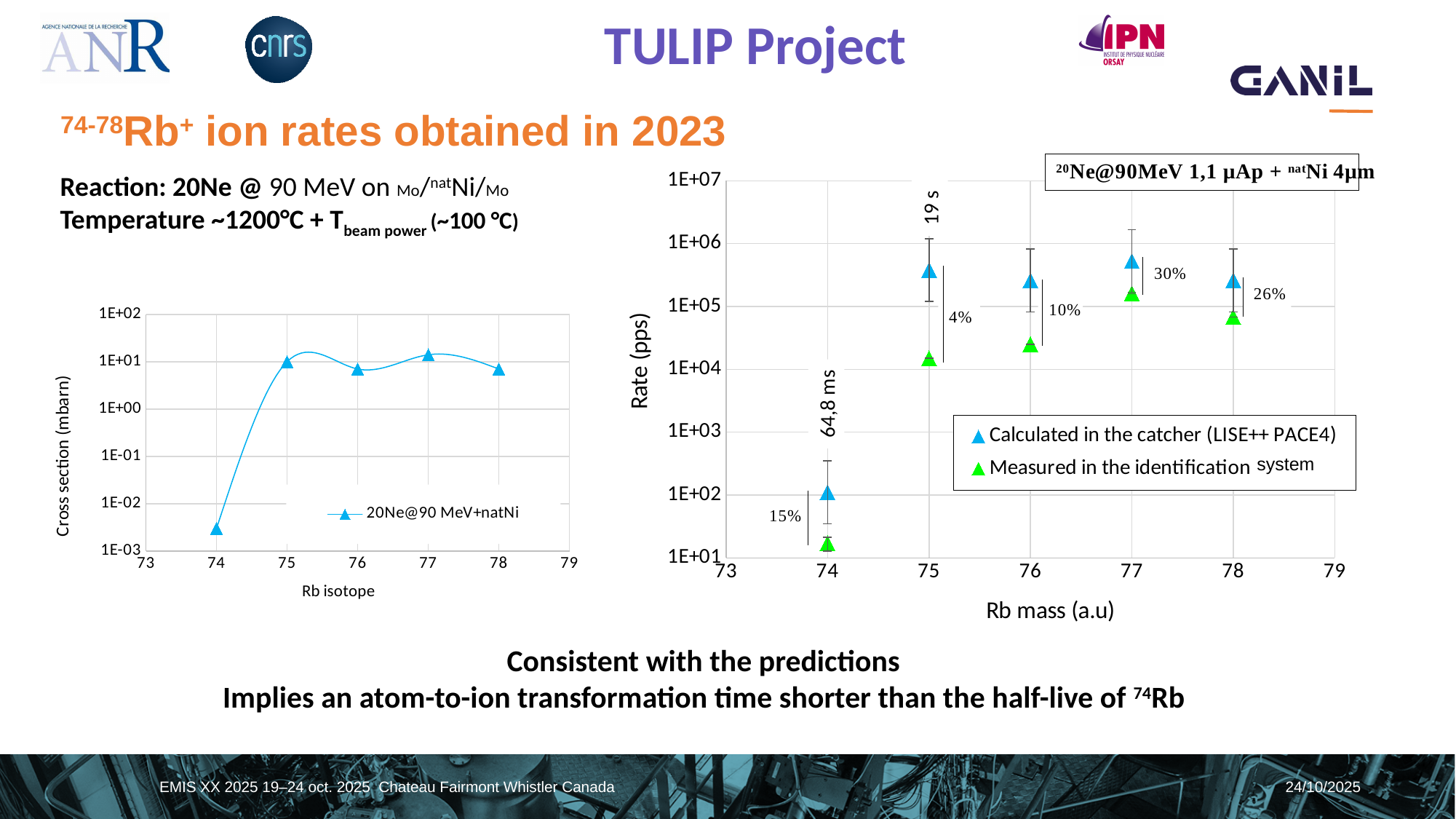
In the right chart (Rate vs Rb mass), how many series does the legend list? 2 In the right chart (Rate vs Rb mass), which Rb mass has the highest measured rate (green series)? 77 In the right chart (Rate vs Rb mass), is the measured rate at Rb mass 77 greater or less than 1E+05? greater In the left chart (Cross section vs Rb isotope), is the cross section for isotope 75 greater or less than 1E+00? greater In the right chart (Rate vs Rb mass), at Rb mass 74, which is larger: the calculated rate or the measured rate? calculated rate In the right chart (Rate vs Rb mass), what percentage label is printed next to the points at Rb mass 77? 30% In the left chart (Cross section vs Rb isotope), how many data points are plotted? 5 In the left chart (Cross section vs Rb isotope), what is the legend entry for the plotted series? 20Ne@90 MeV+natNi What kind of chart is the left chart titled with the y axis 'Cross section (mbarn)'? line chart In the left chart (Cross section vs Rb isotope), is the cross section for isotope 74 greater or less than 1E-02? less In the right chart (Rate vs Rb mass), which Rb mass has the lowest calculated rate (blue series)? 74 In the left chart (Cross section vs Rb isotope), which Rb isotope has the lowest cross section? 74